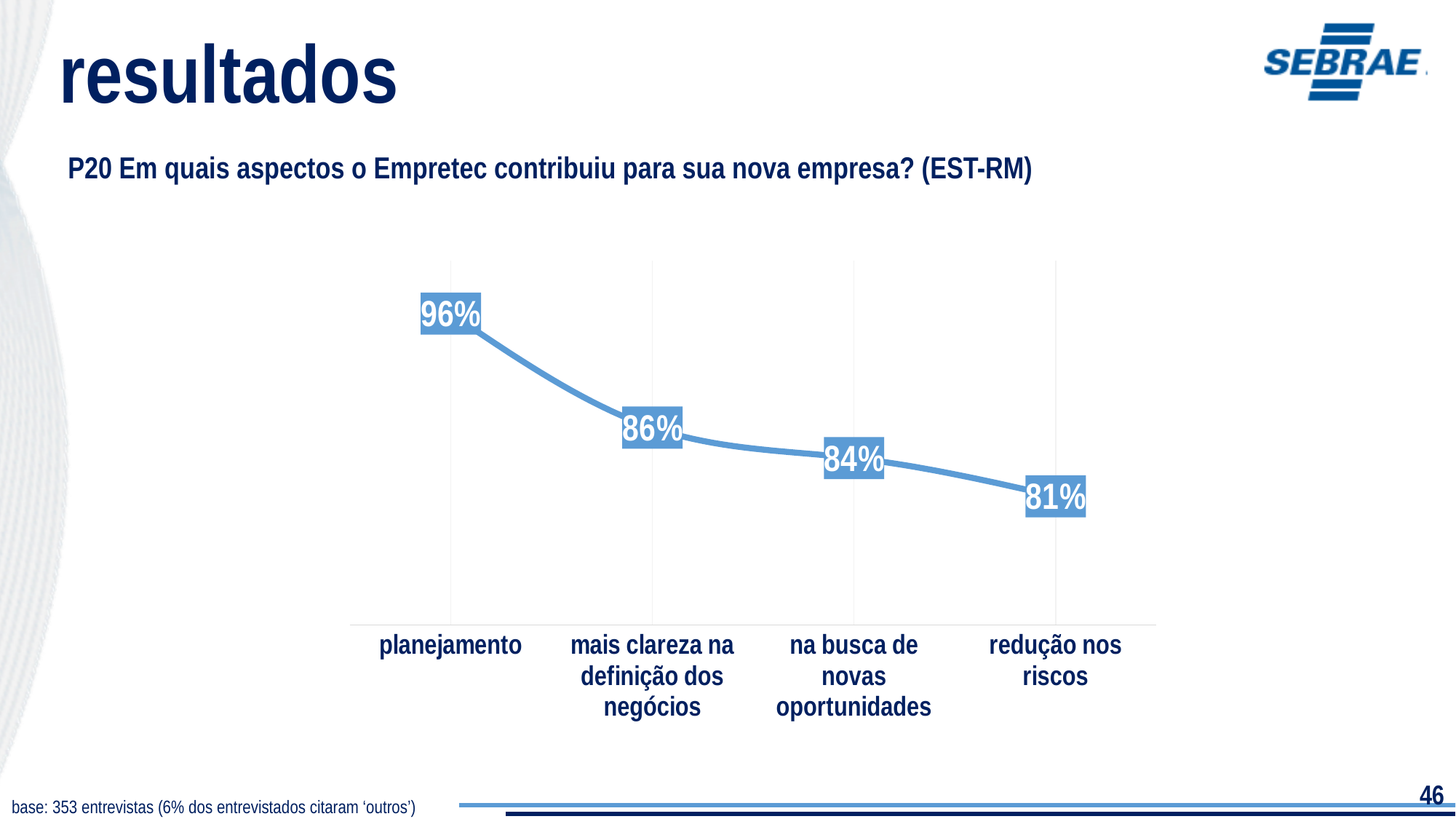
How many categories are plotted on the chart? 4 What kind of chart is shown on the slide? line chart Do the values rise or fall from left to right along the x axis? fall Which category has the lowest value? redução nos riscos What is the difference between the values for mais clareza na definição dos negócios and na busca de novas oportunidades? 2% What is the value for mais clareza na definição dos negócios? 86% Which is larger, the value for na busca de novas oportunidades or the value for redução nos riscos? na busca de novas oportunidades Which category has the highest value? planejamento What is the difference between the values for planejamento and redução nos riscos? 15% What is the value for redução nos riscos? 81% What is the value for planejamento? 96% What is the value for na busca de novas oportunidades? 84%